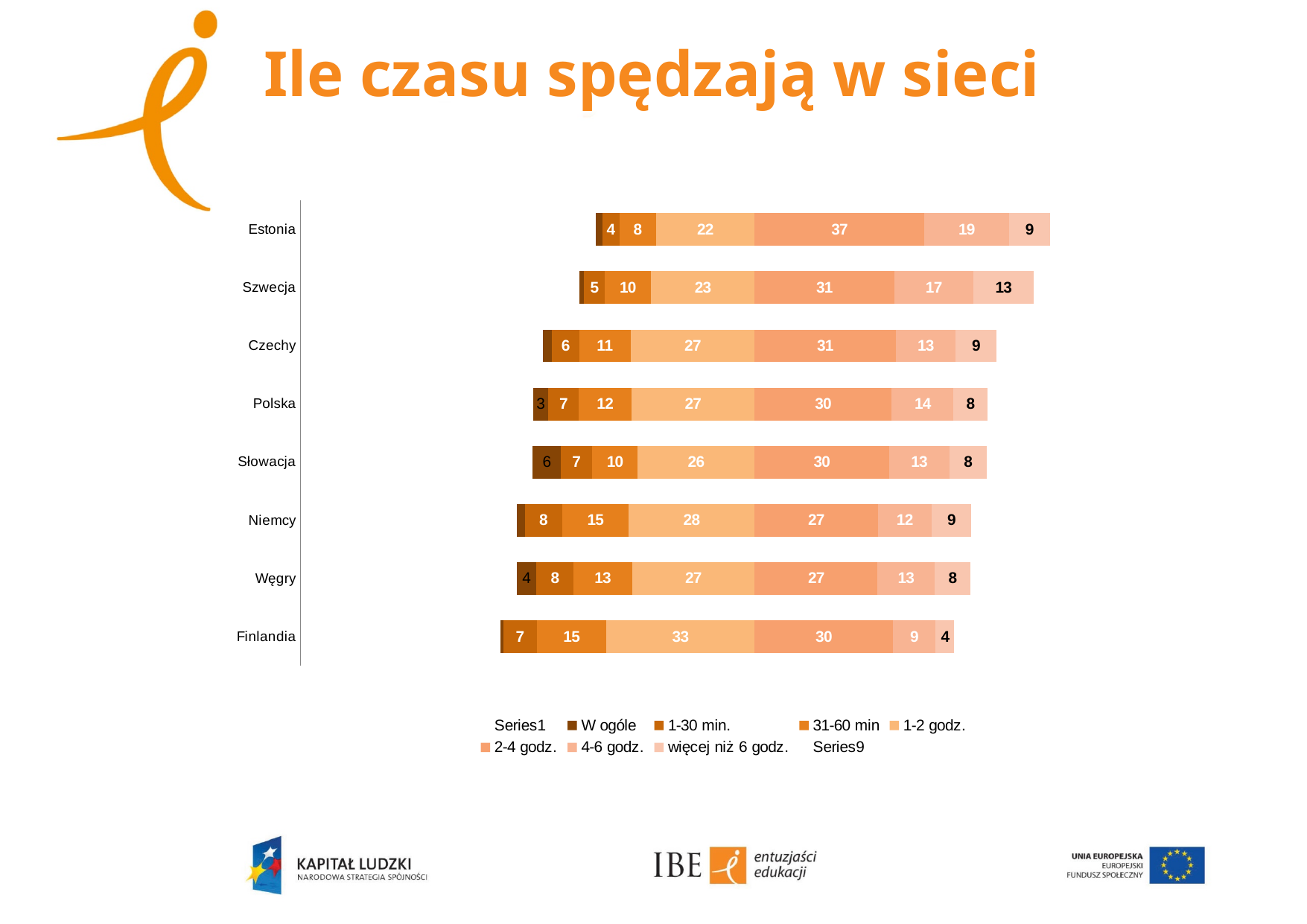
What type of chart is shown on the slide? stacked bar chart What is the value of the '1-2 godz.' segment for Finlandia? 33 What is the value of the 'więcej niż 6 godz.' segment for Szwecja? 13 Which country has the highest value for the '2-4 godz.' segment? Estonia What is the value of the '31-60 min' segment for Polska? 12 What is the total of all labelled segments in the Węgry bar? 100 Which country has the lowest value for the 'więcej niż 6 godz.' segment? Finlandia What is the difference between the '2-4 godz.' values for Estonia and Polska? 7 What is the value of the '2-4 godz.' segment for Estonia? 37 How many entries does the legend list? 9 Which is larger: the '4-6 godz.' value for Szwecja or for Niemcy? Szwecja How many countries are listed on the chart? 8